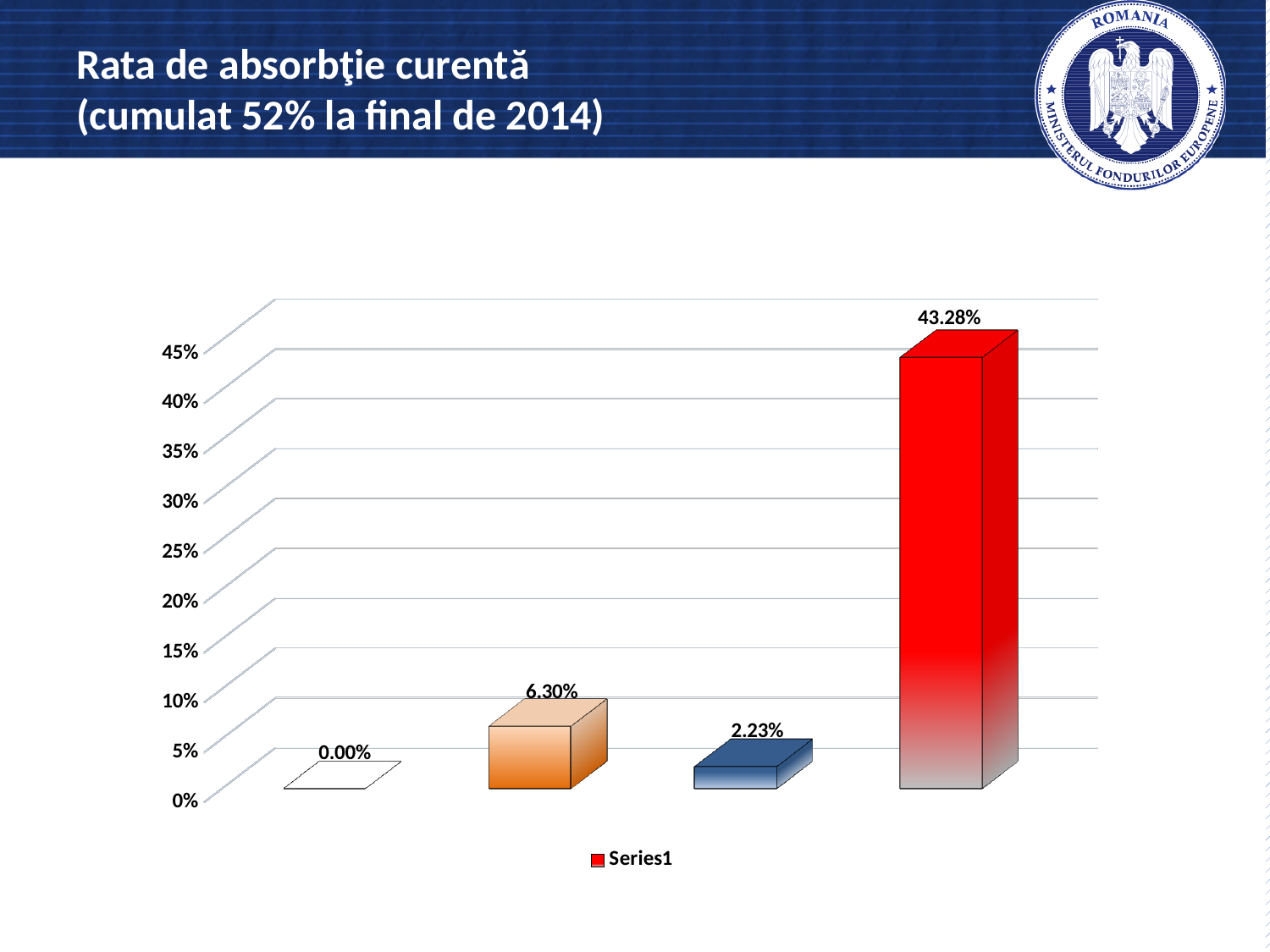
How many series does the legend list? 1 What is the value shown on the orange bar (second from the left)? 6.30% How many bars are plotted in the chart? 4 What type of chart is shown on the slide? bar chart What is the value shown on the first bar from the left? 0.00% What is the value shown on the blue bar (third from the left)? 2.23% Which bar has the lowest value? the first bar from the left, 0.00% Which is larger, the orange bar's value or the blue bar's value? the orange bar (6.30%) What is the name of the series shown in the legend? Series1 Which bar has the highest value? the red bar (fourth from the left), 43.28% What is the difference between the red bar's value and the orange bar's value? 36.98% What is the value shown on the tallest (red) bar? 43.28%